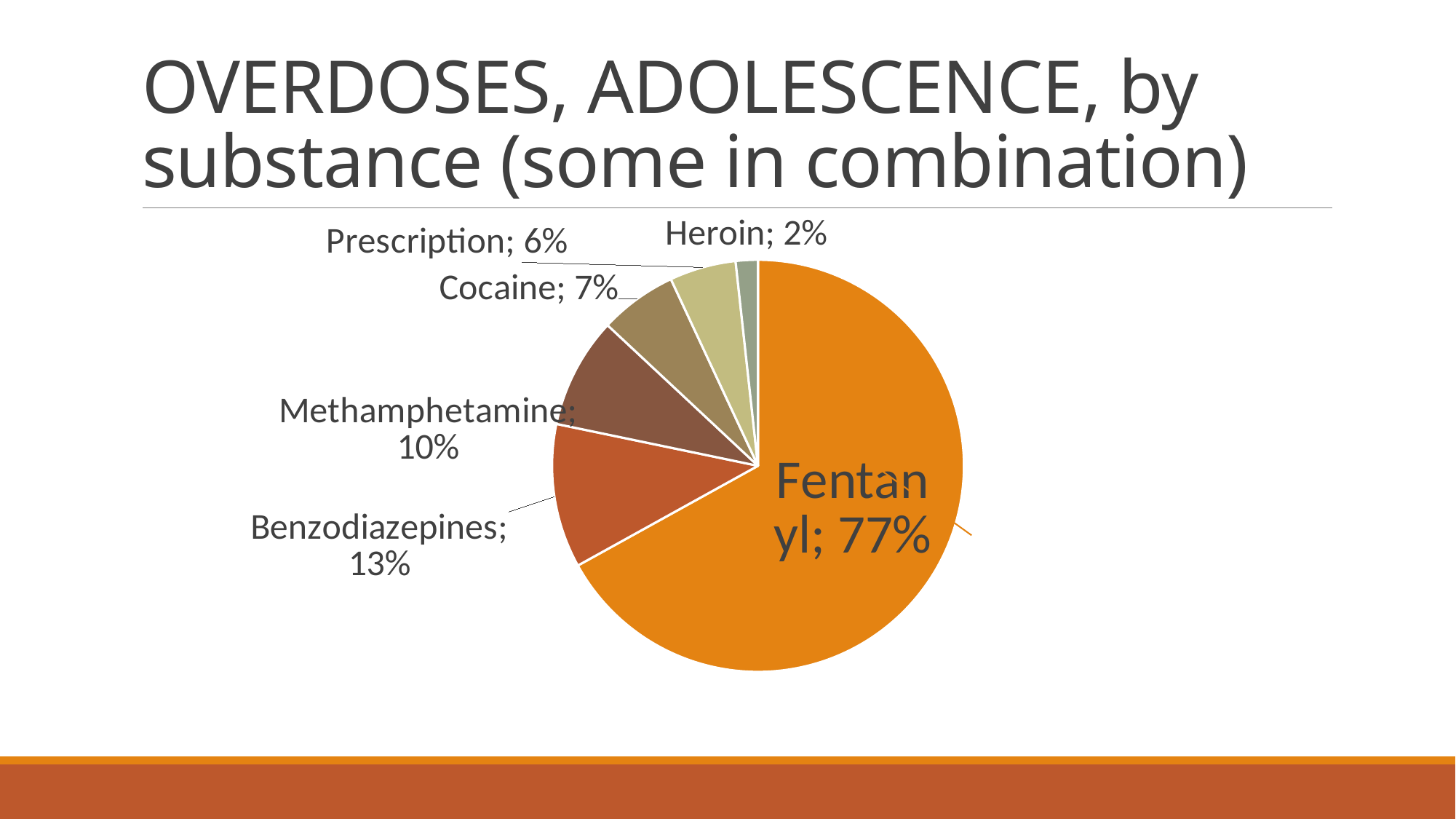
What percentage of overdoses is attributed to Benzodiazepines? 13% Which substance has the smallest share of the pie? Heroin What percentage of overdoses is attributed to Fentanyl? 77% What percentage of overdoses is attributed to Cocaine? 7% What percentage of overdoses is attributed to Methamphetamine? 10% What is the title of the slide containing the chart? OVERDOSES, ADOLESCENCE, by substance (some in combination) What kind of chart is shown on the slide? Pie chart Which has a larger share, Cocaine or Prescription? Cocaine How many substance categories are shown in the pie chart? 6 Which substance has the largest share of the pie? Fentanyl What is the difference in percentage points between Benzodiazepines and Methamphetamine? 3 What percentage of overdoses is attributed to Heroin? 2%